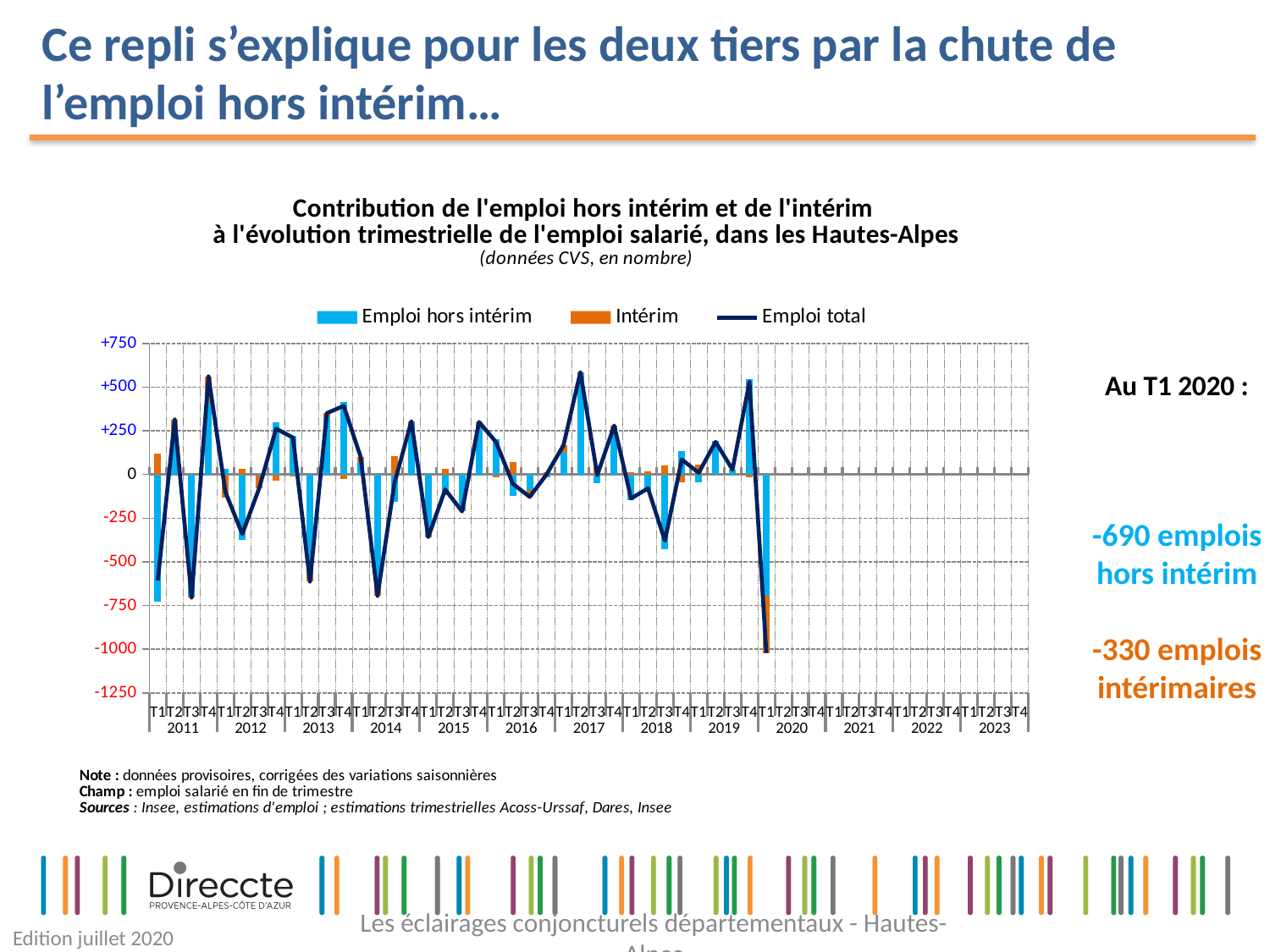
How many series does the chart legend list? 3 Is the value of Emploi total at T4 2019 greater or less than +250? greater What is the value for Emploi hors intérim at T1 2020? -690 emplois What is the value for Intérim at T1 2020? -330 emplois In which quarter does the Emploi total line reach its lowest value? T1 2020 What is the difference between the Emploi hors intérim value (-690) and the Intérim value (-330) at T1 2020? 360 Is the value of Emploi total at T1 2020 greater or less than -750? less What type of chart is shown on the slide? Combined bar and line chart How many years are labelled on the x axis of the chart? 13 At T1 2020, which contributed the larger decline: Emploi hors intérim or Intérim? Emploi hors intérim Which colour represents the Intérim series in the chart? Orange Does the Emploi total line rise or fall between T4 2019 and T1 2020? Fall